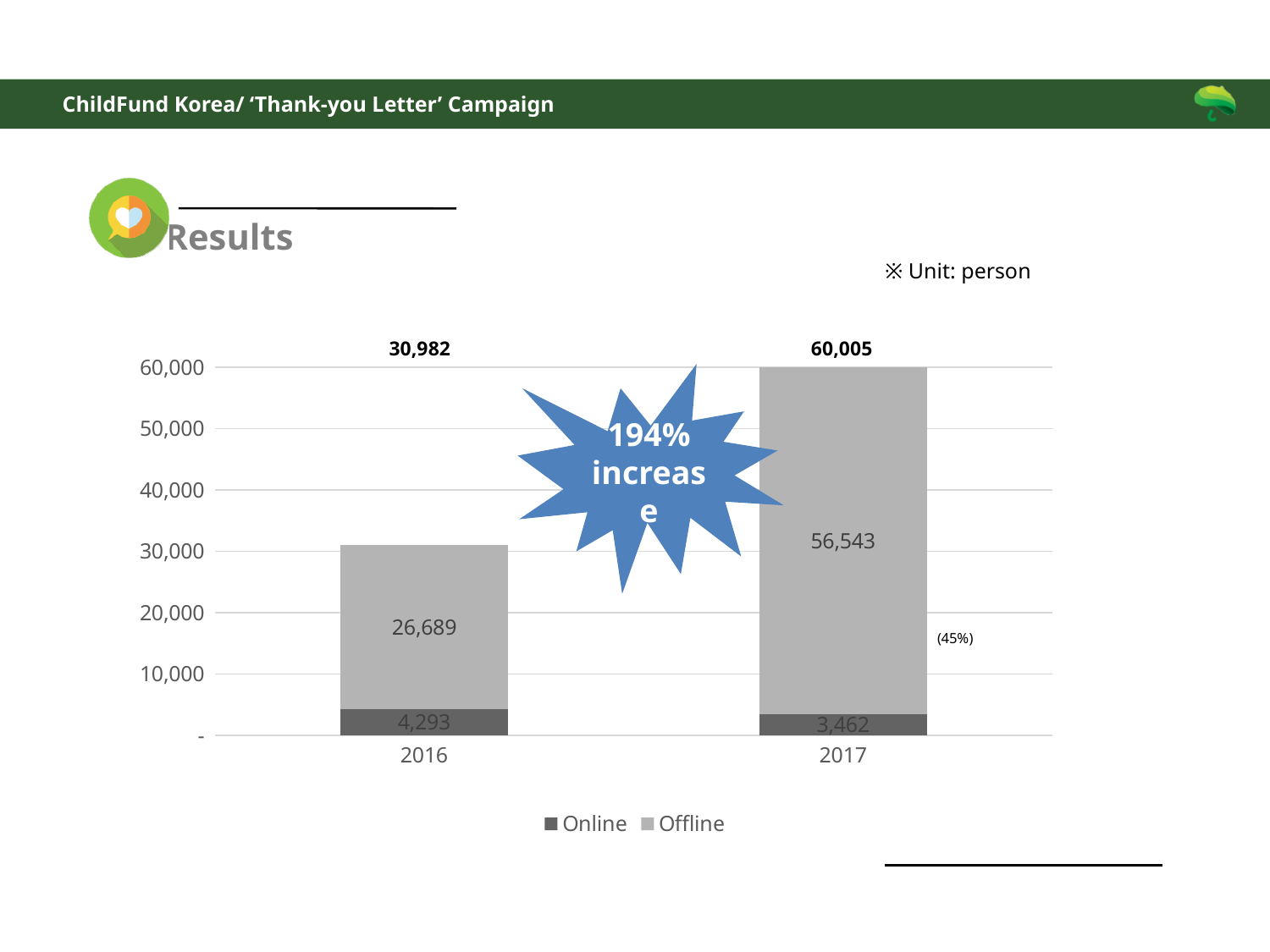
What is the Offline value for 2016? 26,689 What is the Online value for 2016? 4,293 What kind of chart is shown on the slide? Stacked bar chart Which year has the lower Online value? 2017 What is the total of the stacked bar for 2016? 30,982 What unit is stated for the chart values? person What is the Offline value for 2017? 56,543 What is the total of the stacked bar for 2017? 60,005 How many series does the legend list? 2 What is the Online value for 2017? 3,462 What is the difference between the Offline values for 2017 and 2016? 29,854 Which year has the higher Offline value? 2017